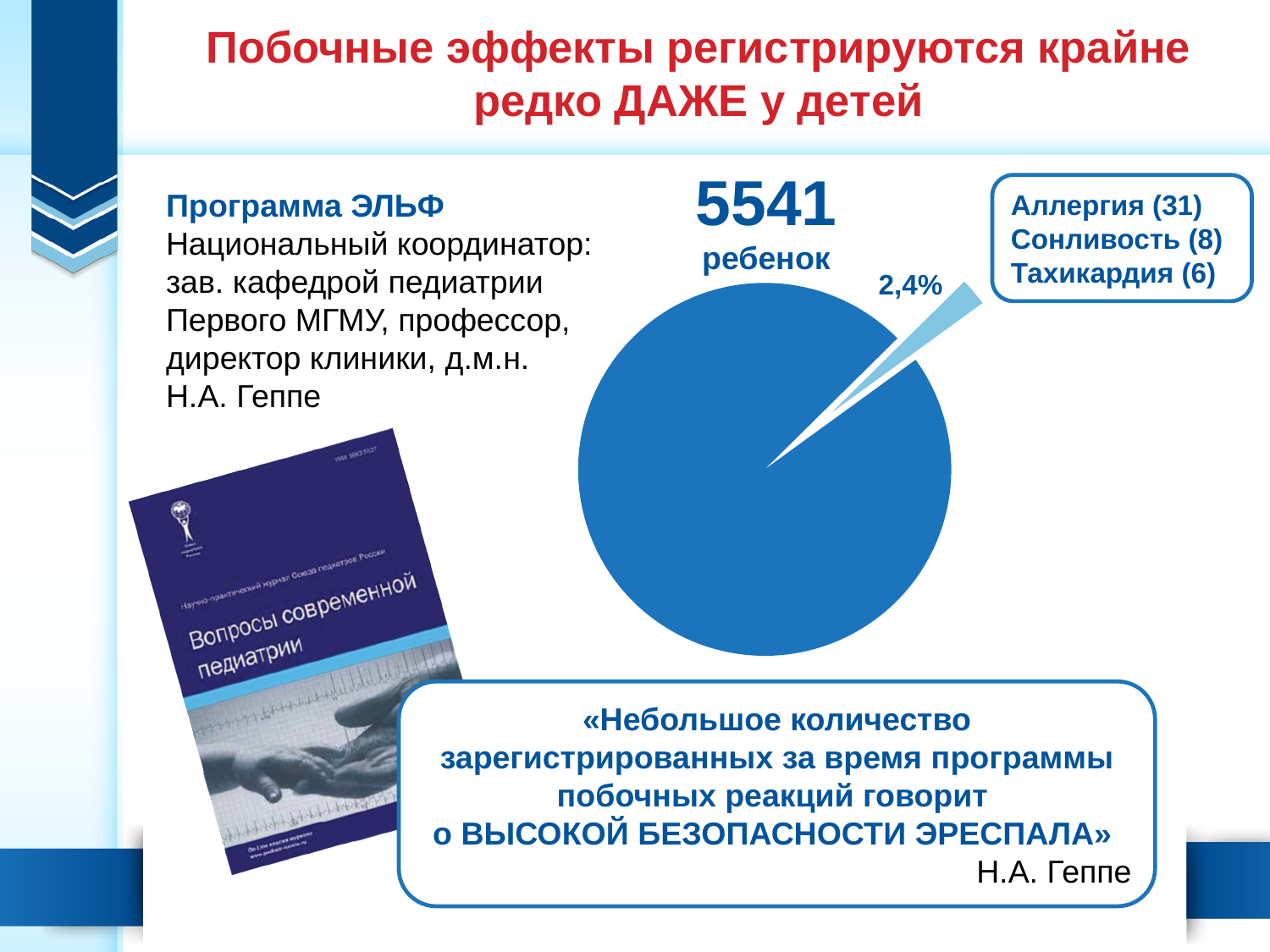
How many slices does the pie chart have? 2 According to the callout next to the pie chart, how many cases of Тахикардия were registered? 6 What is the difference between the number of Аллергия cases and the number of Сонливость cases in the callout? 23 According to the callout next to the pie chart, how many cases of Аллергия were registered? 31 Which side effect in the callout has the lowest number of cases? Тахикардия What total number of children is printed above the pie chart? 5541 What kind of chart is shown on the slide? pie chart What word is printed directly under the number 5541 above the pie chart? ребенок According to the callout next to the pie chart, how many cases of Сонливость were registered? 8 Which slice of the pie is larger, the dark-blue slice or the light-blue slice labelled 2,4%? the dark-blue slice What share of the pie does the small light-blue slice represent? 2,4% Which side effect in the callout has the highest number of cases? Аллергия